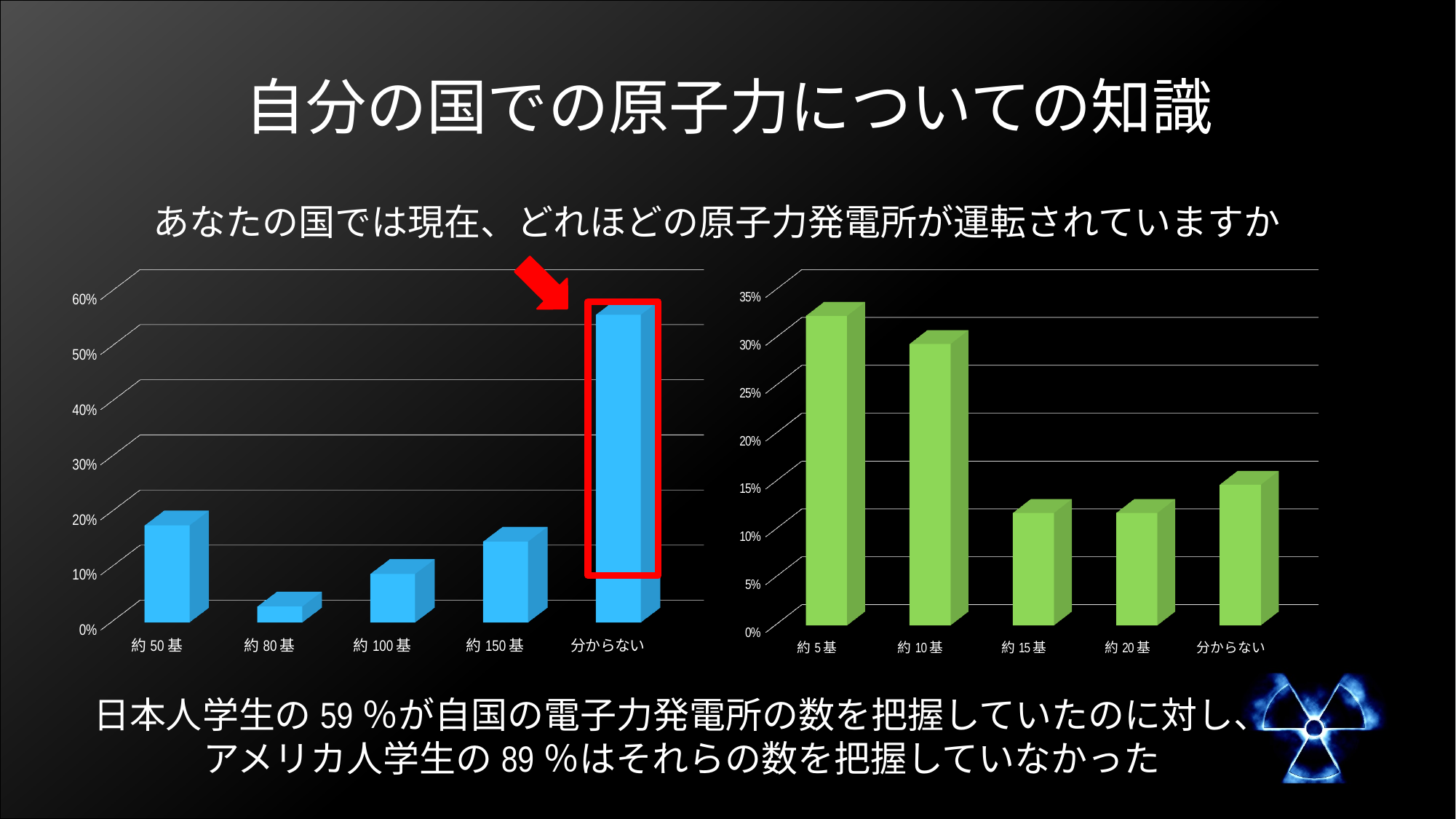
In the right chart, is the value for 約 10 基 greater or less than 25%? greater How many categories are shown in the left chart? 5 In the left chart, which is larger, the value for 約 150 基 or the value for 約 100 基? 約 150 基 In the left chart, which category has the lowest value? 約 80 基 In the right chart, which is larger, the value for 約 5 基 or the value for 約 15 基? 約 5 基 In the right chart, is the value for 分からない greater or less than 20%? less What kind of chart is the right chart? bar chart In the left chart, which category has the highest value? 分からない In the left chart, is the value for 分からない greater or less than 50%? greater What colour are the bars in the right chart? green In the right chart, which category has the highest value? 約 5 基